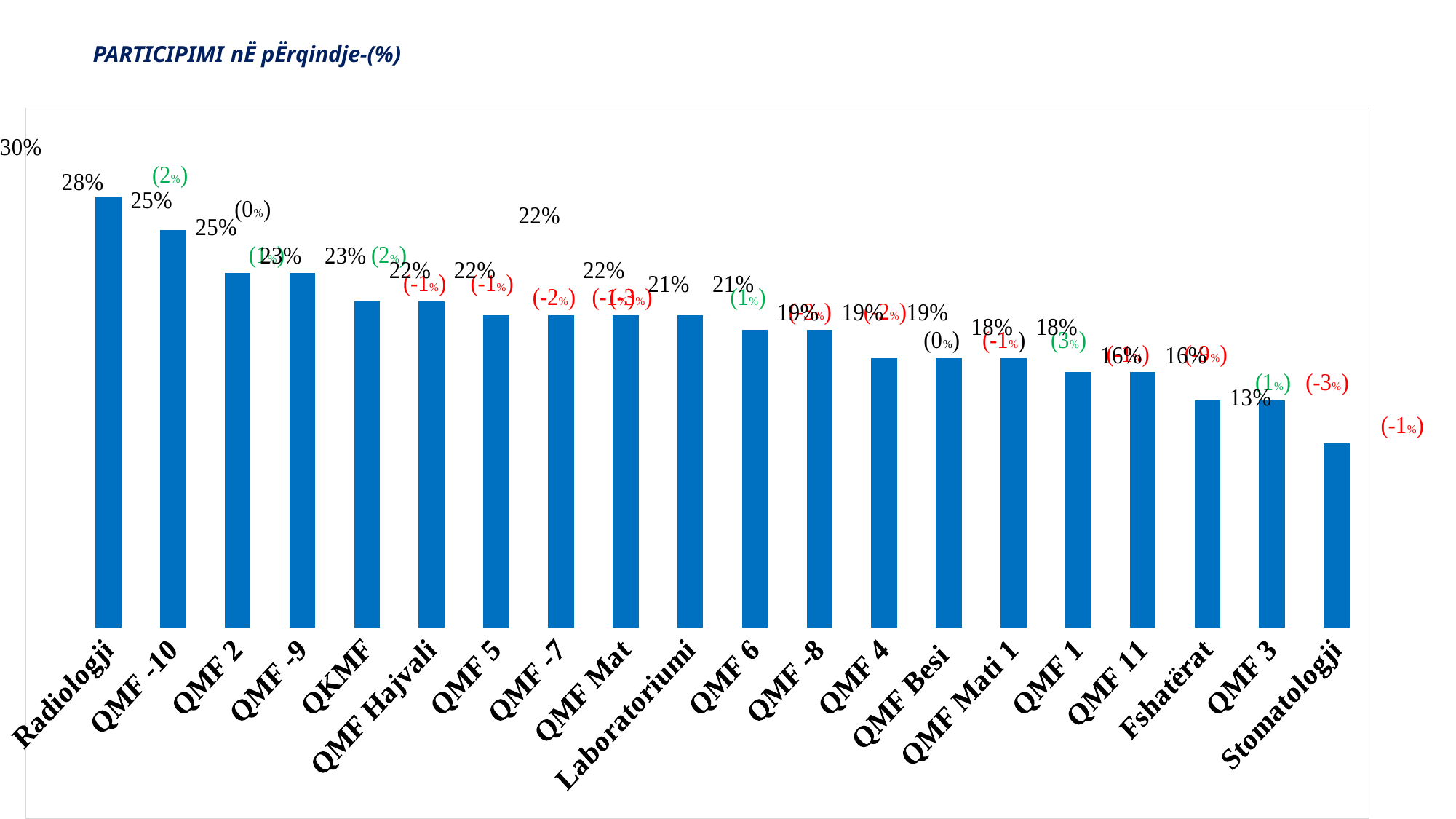
How many categories are shown on the x axis of the chart? 20 Which is larger, the bar for QMF -10 or the bar for QMF 3? QMF -10 Which category has the lowest bar in the chart? Stomatologji Which is larger, the bar for Radiologji or the bar for Stomatologji? Radiologji What is the title of the chart? PARTICIPIMI nË pËrqindje-(%) Which category has the highest bar in the chart? Radiologji Do the bar values generally rise or fall from left to right along the x axis? fall What is the label of the first category on the left of the x axis? Radiologji What kind of chart is shown on the slide? bar chart Which is larger, the bar for Fshatërat or the bar for QMF 2? QMF 2